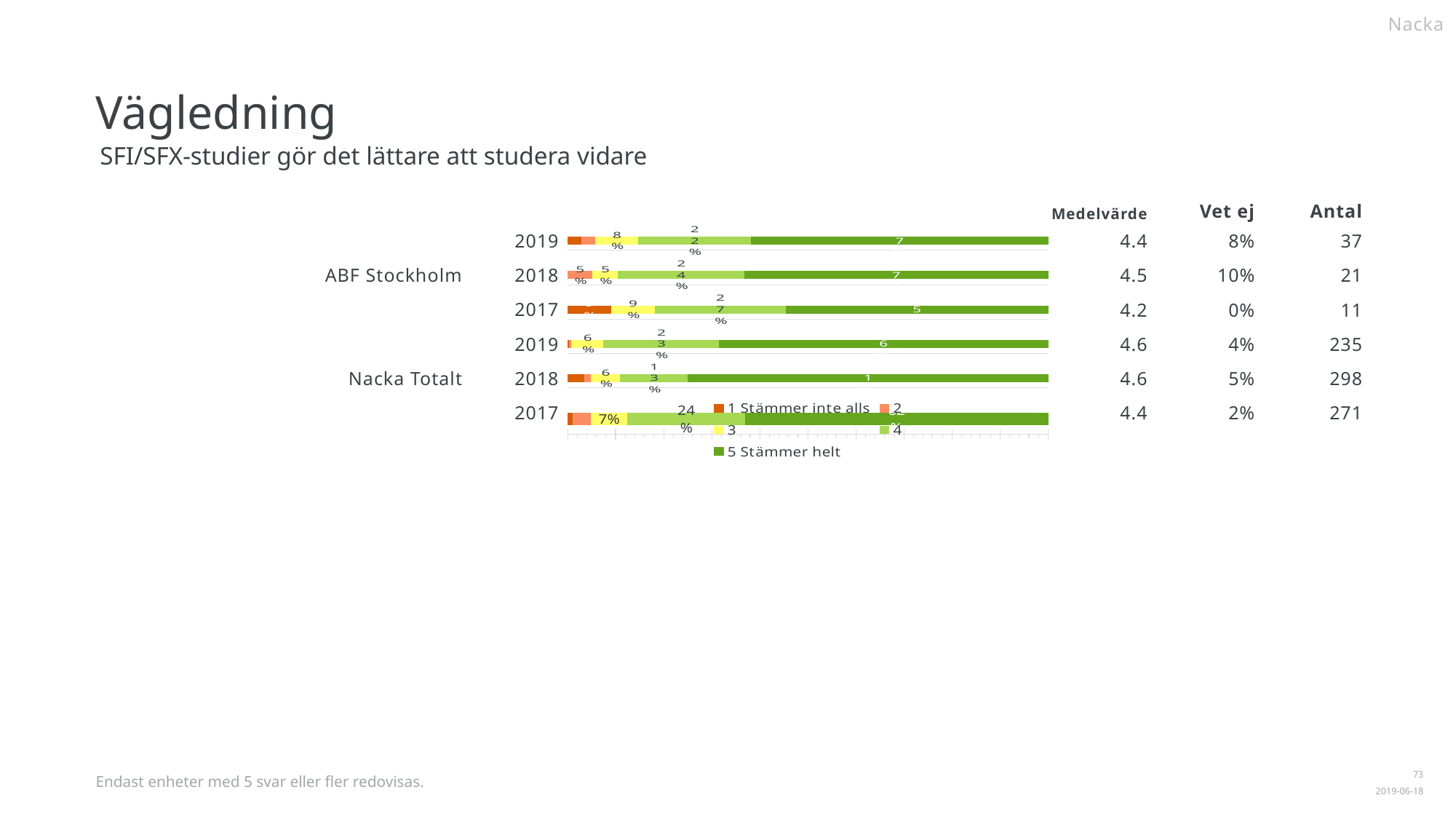
What is the difference between the '4' segment for ABF Stockholm 2018 and for ABF Stockholm 2019? 2 percentage points What is the value of the '4' segment for ABF Stockholm 2018? 24% How many bars are plotted in the chart? 6 What is the value of the '4' segment for ABF Stockholm 2019? 22% How many series does the chart legend list? 5 What is the value of the '3' segment for ABF Stockholm 2019? 8% Which has the larger '3' segment: ABF Stockholm 2019 or Nacka Totalt 2019? ABF Stockholm 2019 What is the value of the '4' segment for Nacka Totalt 2019? 23% What is the value of the '3' segment for Nacka Totalt 2017? 7% What kind of chart is shown on the slide? bar chart What is the value of the '3' segment for ABF Stockholm 2017? 9%